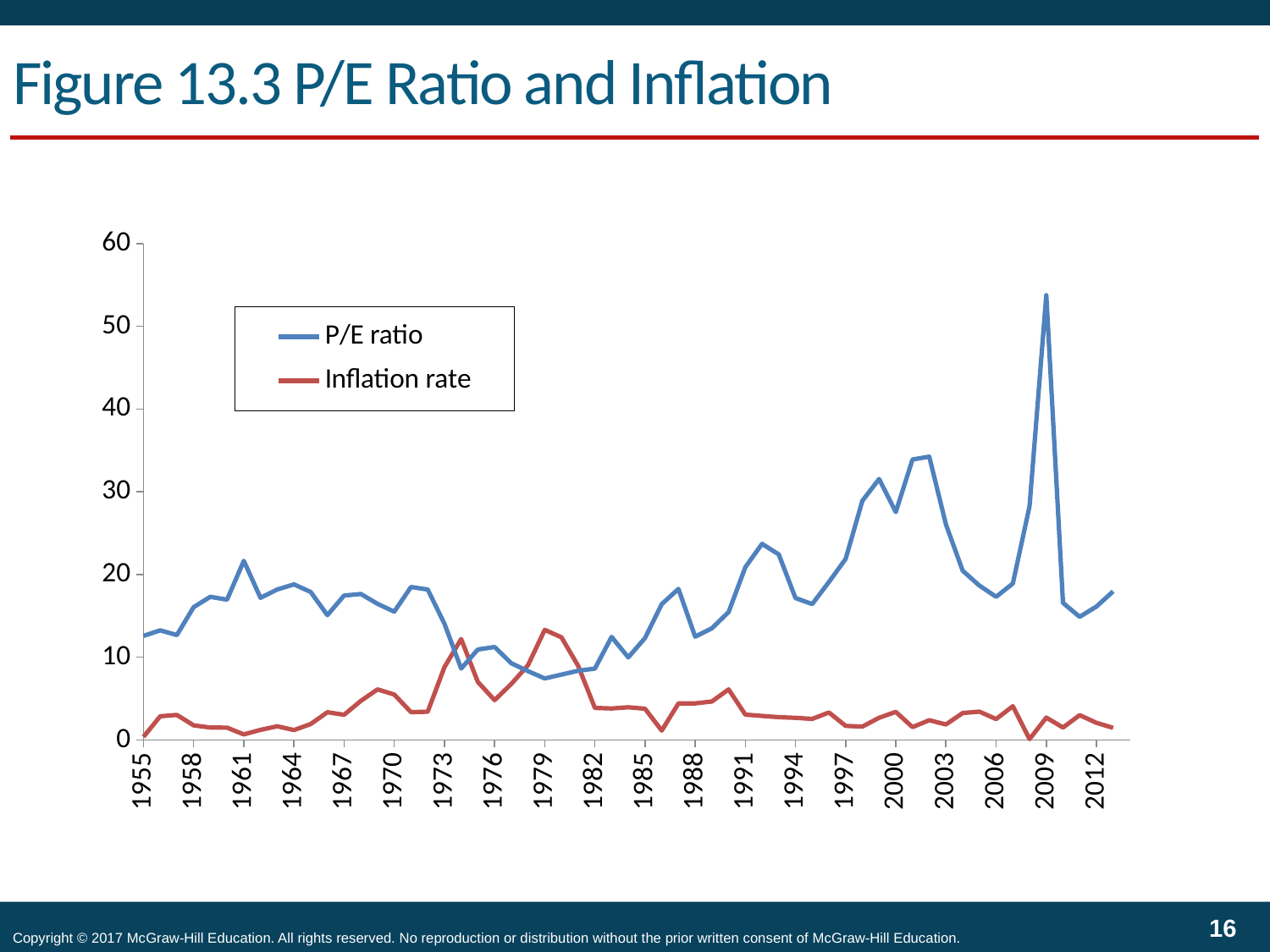
In which year does the P/E ratio reach its highest value? 2009 Is the inflation rate in 1979 greater or less than 10? greater Is the P/E ratio in 2009 greater or less than 50? greater In 2000, which is higher, the P/E ratio or the inflation rate? P/E ratio How many series does the legend list? 2 Does the P/E ratio generally rise or fall from 1982 to 2000? rise What colour is the line for the P/E ratio? blue Is the P/E ratio in 2003 greater or less than 30? less What kind of chart is shown on the slide? line chart In 1979, which is higher, the P/E ratio or the inflation rate? Inflation rate What is the title of the chart? Figure 13.3 P/E Ratio and Inflation